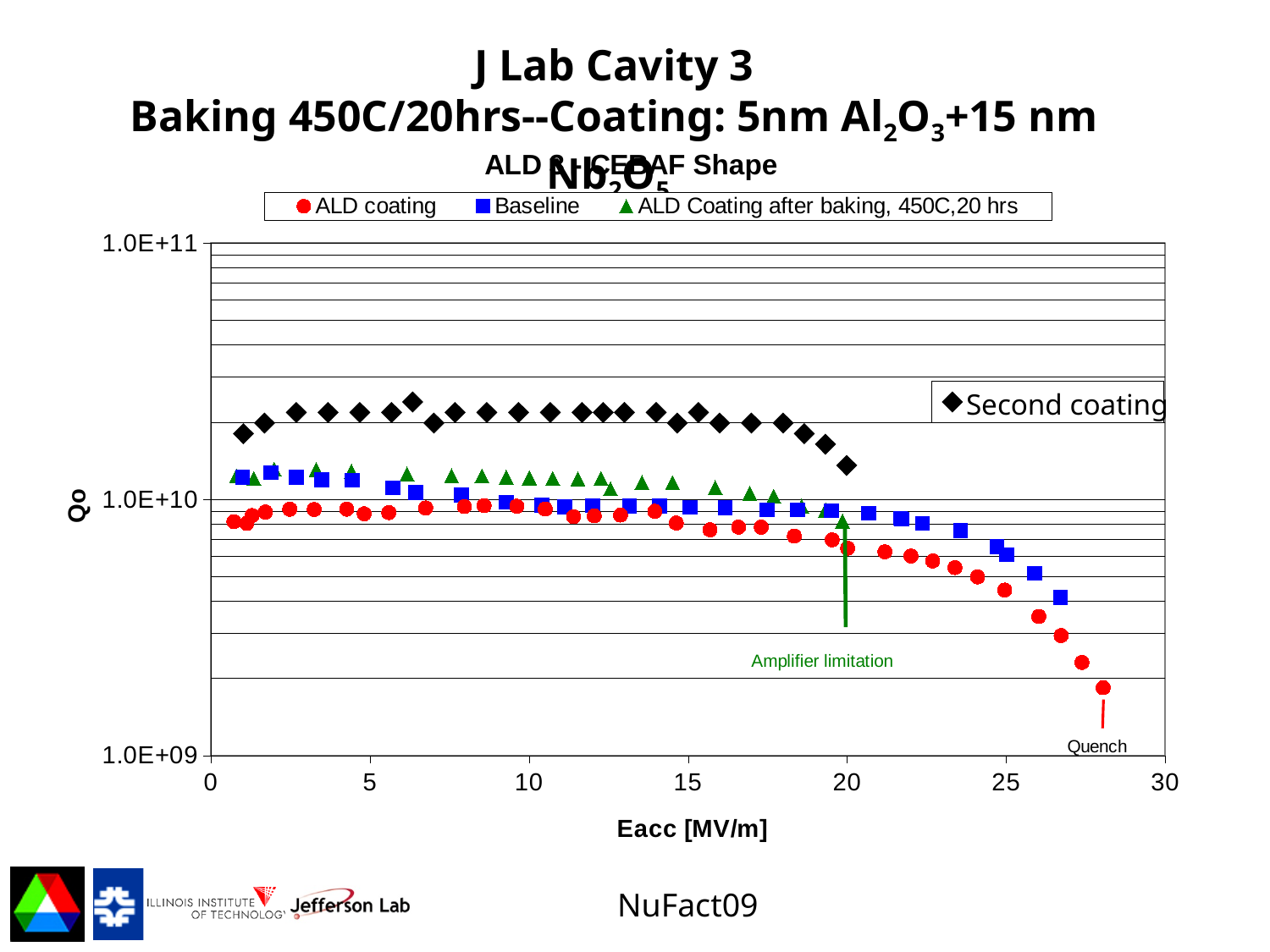
Does the Qo of the ALD coating series rise or fall as Eacc increases beyond 15 MV/m? fall At Eacc of about 25 MV/m, which series has the higher Qo: Baseline or ALD coating? Baseline Which series extends to the highest Eacc value on the chart? ALD coating What is the label on the x axis of the chart? Eacc [MV/m] What kind of chart is shown on the slide? scatter chart How many series does the legend at the top of the chart list? 3 Which series has the highest Qo values across the plotted Eacc range? Second coating What annotation is written next to the green arrow at Eacc of 20 MV/m? Amplifier limitation Is the Qo value for the ALD coating series at Eacc of about 28 MV/m greater or less than 1.0E+10? less Are the Qo values for the Second coating series greater or less than 1.0E+10? greater